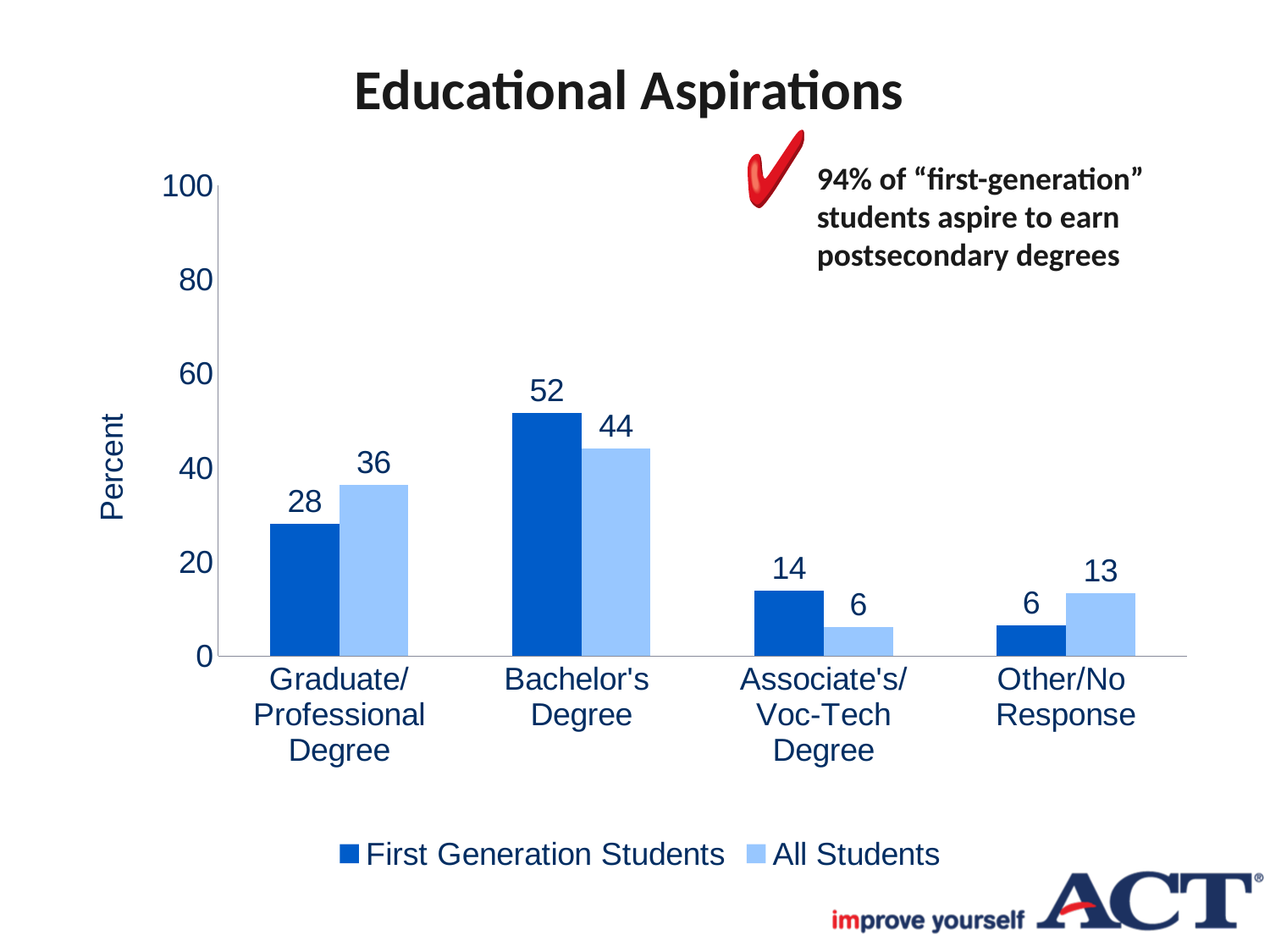
Which is larger for Associate's/Voc-Tech Degree: First Generation Students or All Students? First Generation Students What kind of chart is shown on the slide? bar chart What is the title of the chart? Educational Aspirations Which category has the lowest value for All Students? Associate's/Voc-Tech Degree What is the value for All Students for Graduate/Professional Degree? 36 What is the value for First Generation Students for Bachelor's Degree? 52 How many series does the legend list? 2 How many categories are shown on the x axis? 4 Which category has the highest value for First Generation Students? Bachelor's Degree What is the difference between First Generation Students and All Students for Bachelor's Degree? 8 What is the value for All Students for Other/No Response? 13 Is the value for First Generation Students for Graduate/Professional Degree greater or less than 40? less